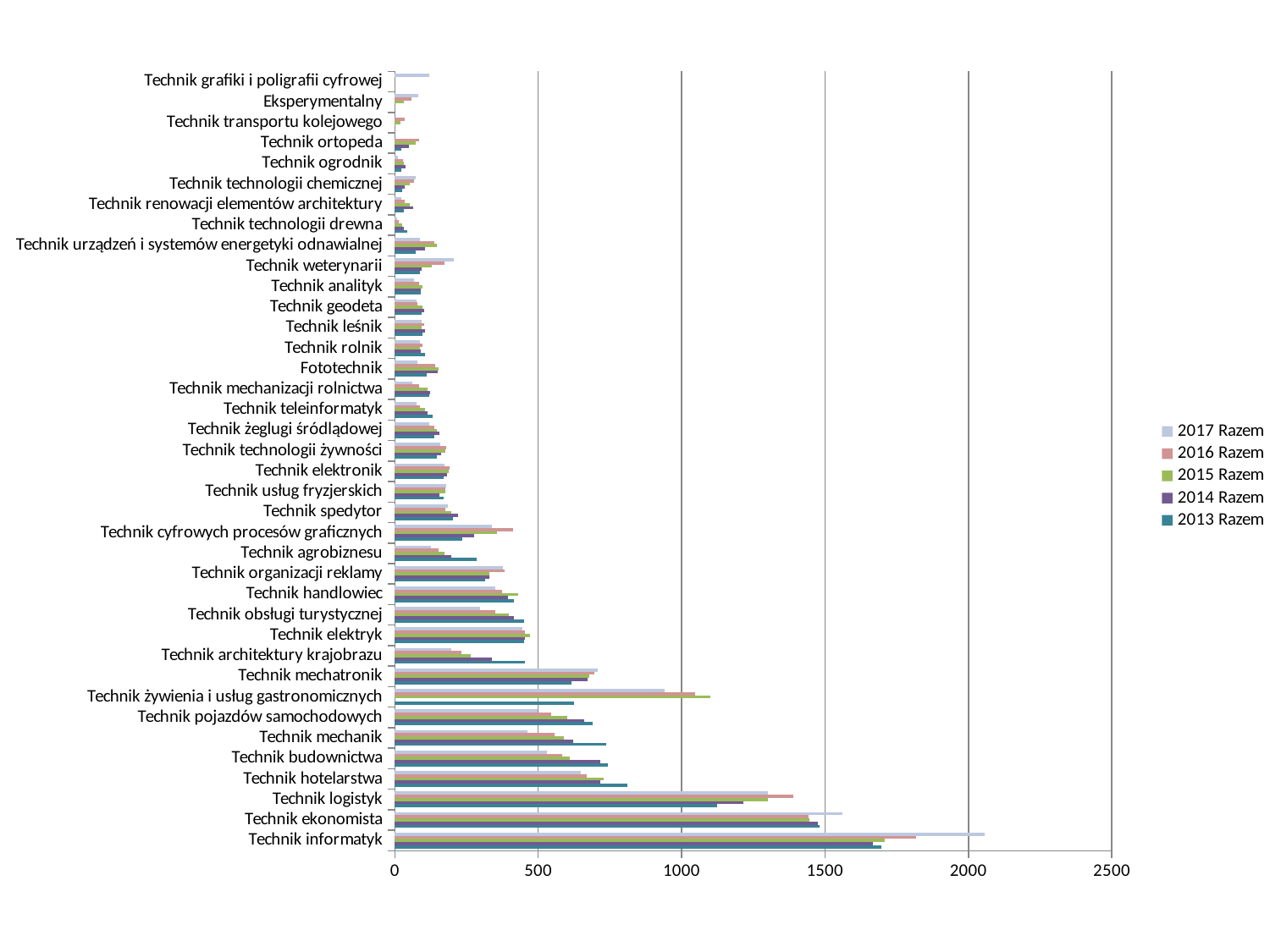
For Technik żywienia i usług gastronomicznych, which is larger: the 2013 Razem value or the 2015 Razem value? 2015 Razem Is the 2017 Razem value for Technik ekonomista greater or less than 1500? greater How many series does the legend list? 5 How many categories (professions) are plotted on the chart? 38 What kind of chart is shown on the slide? bar chart Is the 2017 Razem value for Technik architektury krajobrazu greater or less than 500? less Which category has the highest value for the 2017 Razem series? Technik informatyk Is the 2017 Razem value for Technik informatyk greater or less than 2000? greater What is the highest value shown on the horizontal axis? 2500 Which is larger for the 2013 Razem series: Technik informatyk or Technik logistyk? Technik informatyk